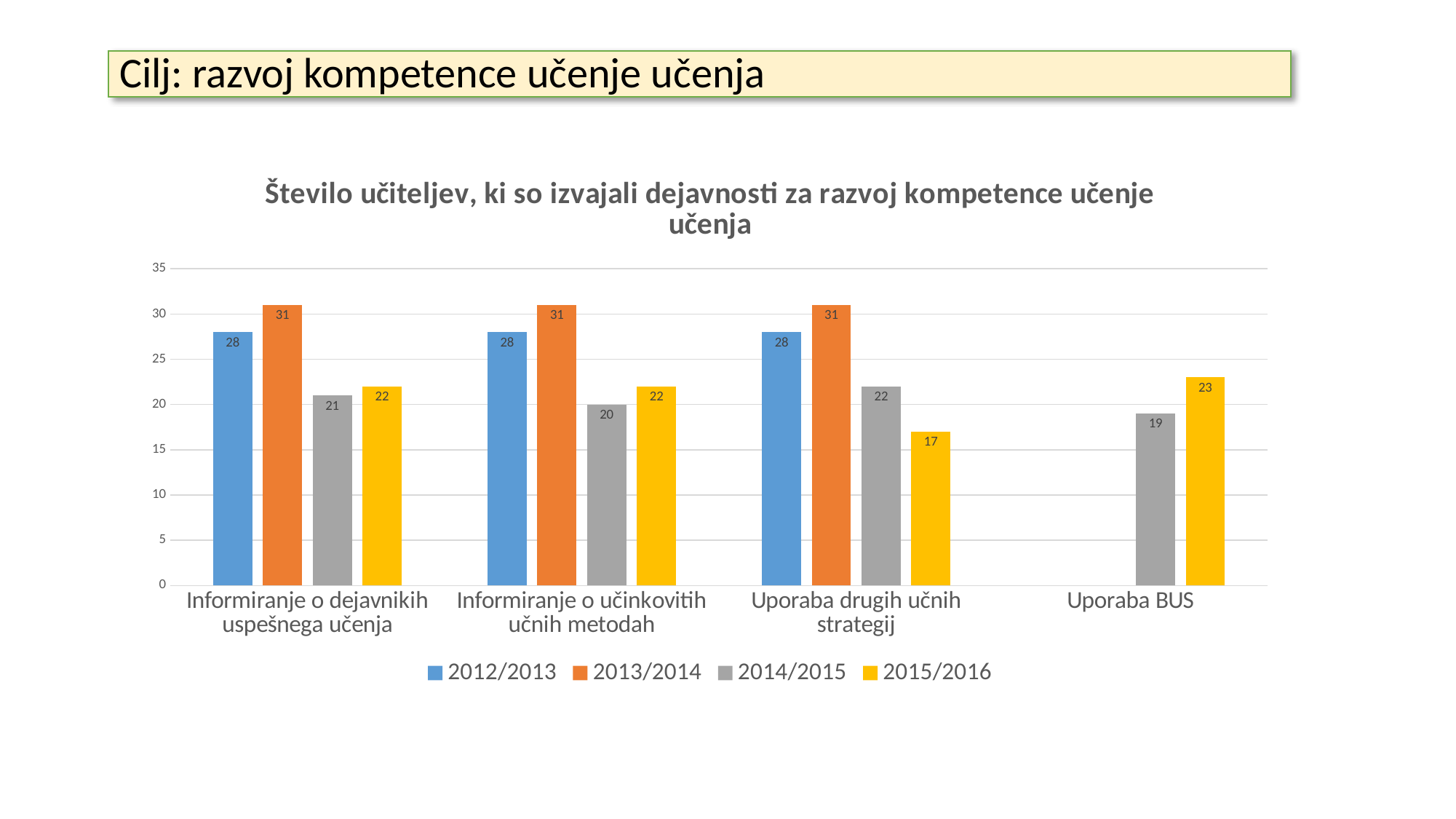
What is the value for 2014/2015 in the category 'Informiranje o učinkovitih učnih metodah'? 20 In the category 'Uporaba BUS', which is larger: the value for 2014/2015 or the value for 2015/2016? 2015/2016 Which series has the highest value in the category 'Uporaba drugih učnih strategij'? 2013/2014 Is the value for 2015/2016 in the category 'Uporaba drugih učnih strategij' greater or less than 20? less What is the value for 2015/2016 in the category 'Uporaba BUS'? 23 How many categories are shown on the x axis? 4 How many series does the legend list? 4 What is the difference between the 2013/2014 and 2012/2013 values in the category 'Informiranje o učinkovitih učnih metodah'? 3 Which series has the lowest value in the category 'Uporaba drugih učnih strategij'? 2015/2016 What colour represents the 2014/2015 series in the legend? grey What is the value for 2013/2014 in the category 'Informiranje o dejavnikih uspešnega učenja'? 31 What kind of chart is shown on the slide? bar chart